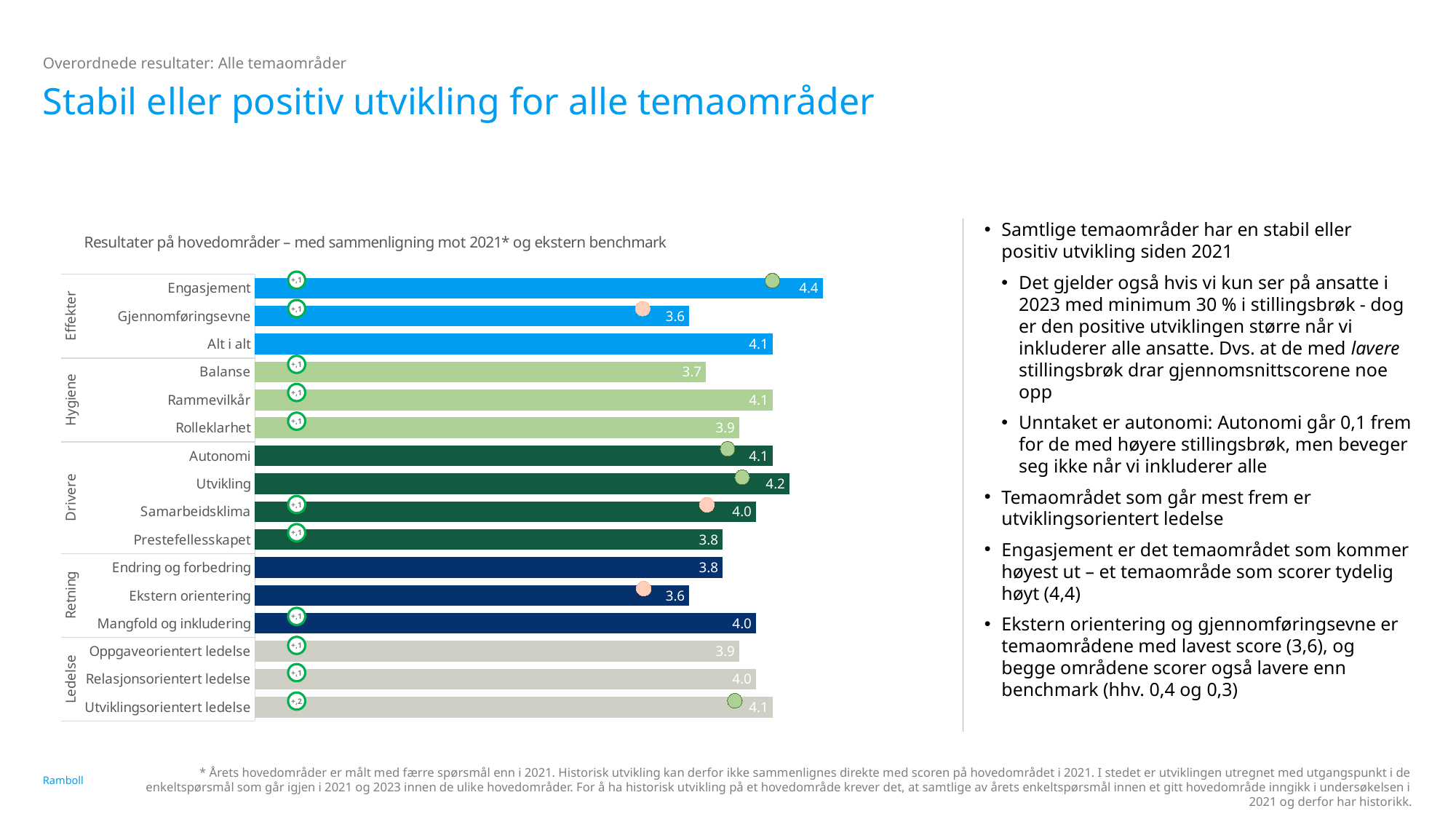
What is the difference between the values for Utvikling and Prestefellesskapet? 0.4 How many categories are plotted in the chart? 16 What is the value for Mangfold og inkludering? 4.0 How many groups (Effekter, Hygiene, etc.) are the categories divided into along the left side of the chart? 5 What kind of chart is shown on the slide? Bar chart Which is larger, the value for Utvikling or the value for Balanse? Utvikling Which category has the highest value? Engasjement What is the value for Engasjement? 4.4 What is the value for Balanse? 3.7 What is the difference between the values for Engasjement and Gjennomføringsevne? 0.8 What is the value for Utvikling? 4.2 What is the title of the chart? Resultater på hovedområder – med sammenligning mot 2021* og ekstern benchmark